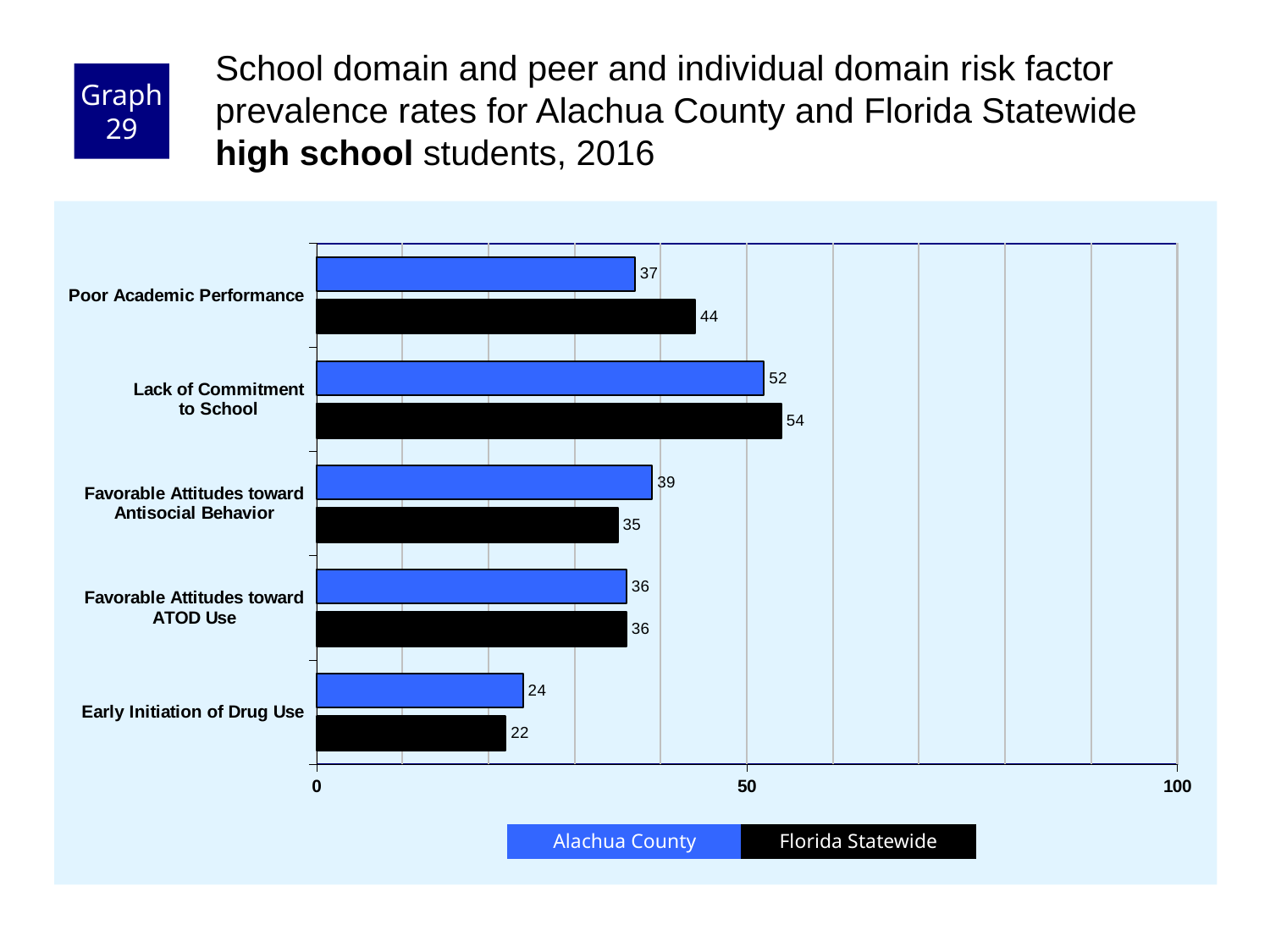
How many series does the legend list? 2 What is the Alachua County value for Poor Academic Performance? 37 Which colour represents Florida Statewide in the chart? Black What kind of chart is shown on the slide? Bar chart Which risk factor has the lowest Florida Statewide value? Early Initiation of Drug Use What is the Florida Statewide value for Early Initiation of Drug Use? 22 What is the Florida Statewide value for Lack of Commitment to School? 54 Is the Alachua County value for Lack of Commitment to School greater or less than 50? greater How many risk factor categories are shown on the chart? 5 For Favorable Attitudes toward Antisocial Behavior, which is larger: the Alachua County value or the Florida Statewide value? Alachua County What is the difference between the Florida Statewide and Alachua County values for Poor Academic Performance? 7 Which risk factor has the highest Alachua County value? Lack of Commitment to School